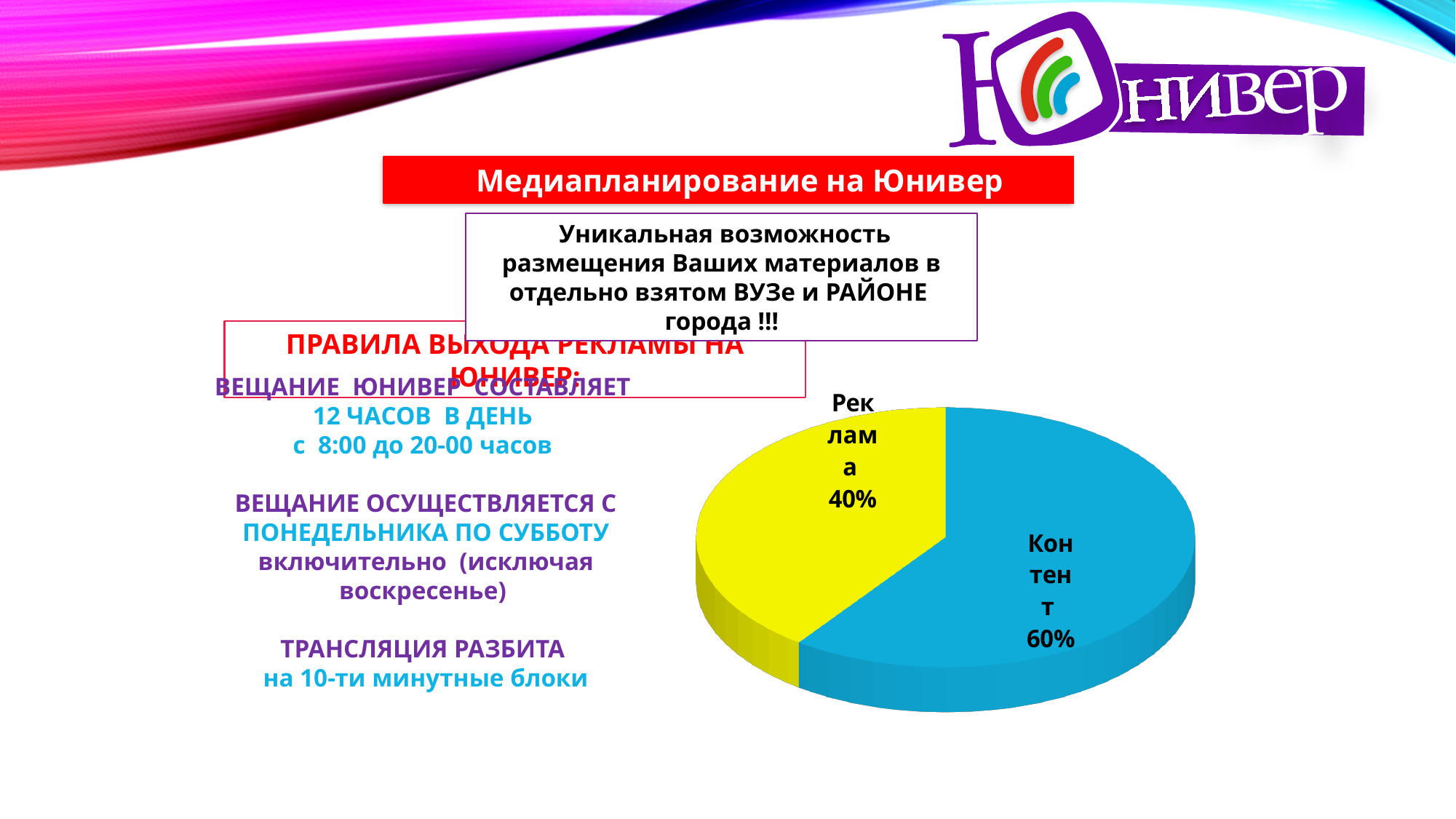
Which is larger in the pie chart, Реклама or Контент? Контент What share of the pie does Реклама take? 40% Which slice of the pie chart is the smallest? Реклама What share of the pie does Контент take? 60% What is the difference in percentage points between Контент and Реклама? 20% What colour is the Реклама slice of the pie chart? yellow Which slice of the pie chart is the largest? Контент What colour is the Контент slice of the pie chart? blue Is the share for Реклама greater or less than 50%? less How many slices does the pie chart have? 2 What kind of chart is shown on the slide? pie chart